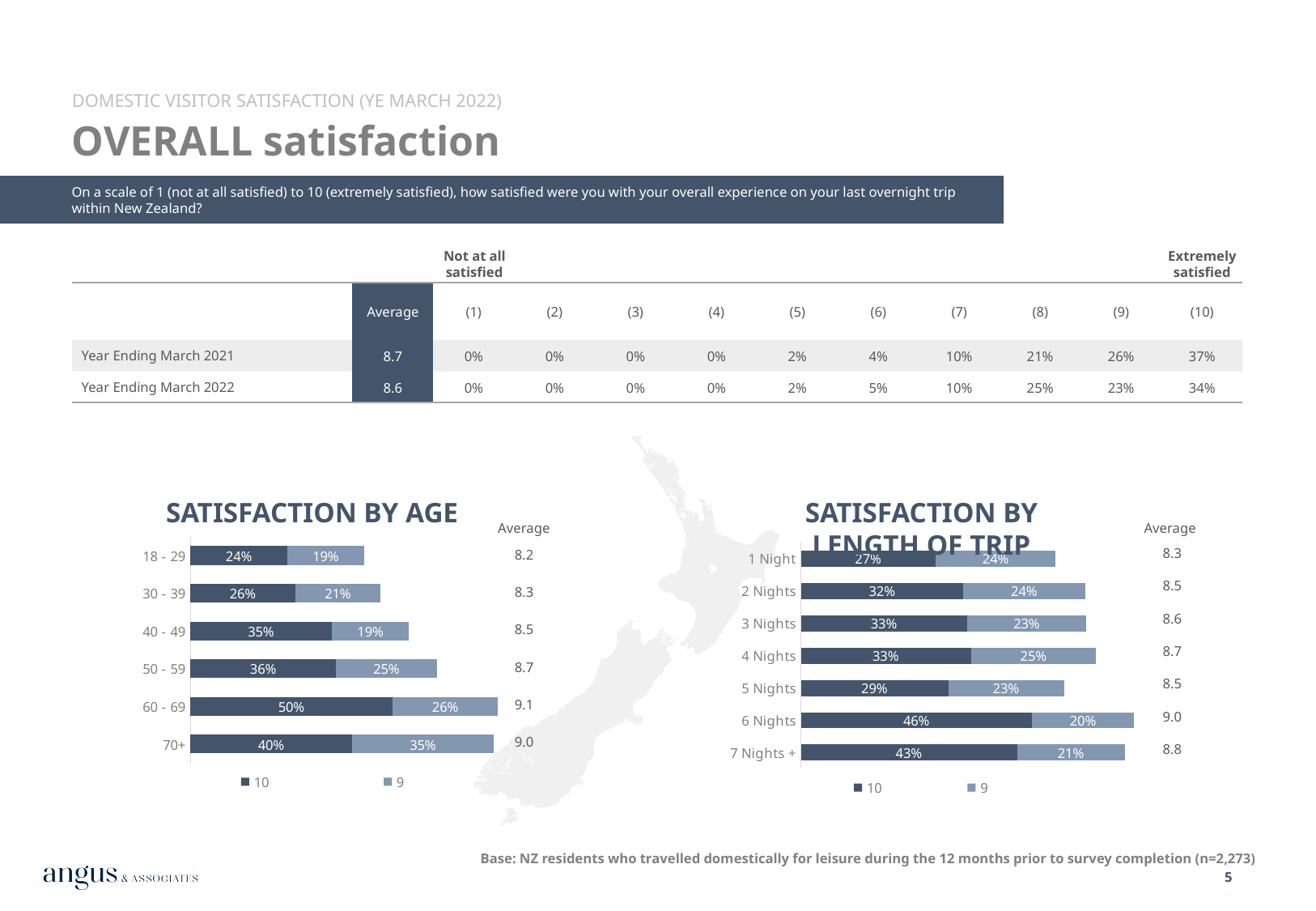
In the SATISFACTION BY AGE chart, which age group has the lowest percentage giving a rating of 10? 18 - 29 In the SATISFACTION BY AGE chart, which age group has the highest percentage giving a rating of 10? 60 - 69 In the SATISFACTION BY AGE chart, what is the combined percentage of 10 and 9 ratings for the 60 - 69 age group? 76% In the SATISFACTION BY AGE chart, how many age groups are shown? 6 In the SATISFACTION BY LENGTH OF TRIP chart, which trip length has the lowest percentage giving a rating of 10? 1 Night In the SATISFACTION BY AGE chart, what percentage of the 70+ age group gave a rating of 9? 35% In the SATISFACTION BY LENGTH OF TRIP chart, what percentage of 4 Nights travellers gave a rating of 9? 25% In the SATISFACTION BY LENGTH OF TRIP chart, what is the difference between the percentage of 10 ratings for 6 Nights and for 1 Night? 19% In the SATISFACTION BY LENGTH OF TRIP chart, how many series does the legend list? 2 What type of chart is the SATISFACTION BY LENGTH OF TRIP chart? Stacked bar chart In the SATISFACTION BY LENGTH OF TRIP chart, what percentage of 6 Nights travellers gave a rating of 10? 46% In the SATISFACTION BY AGE chart, what percentage of the 60 - 69 age group gave a rating of 10? 50%